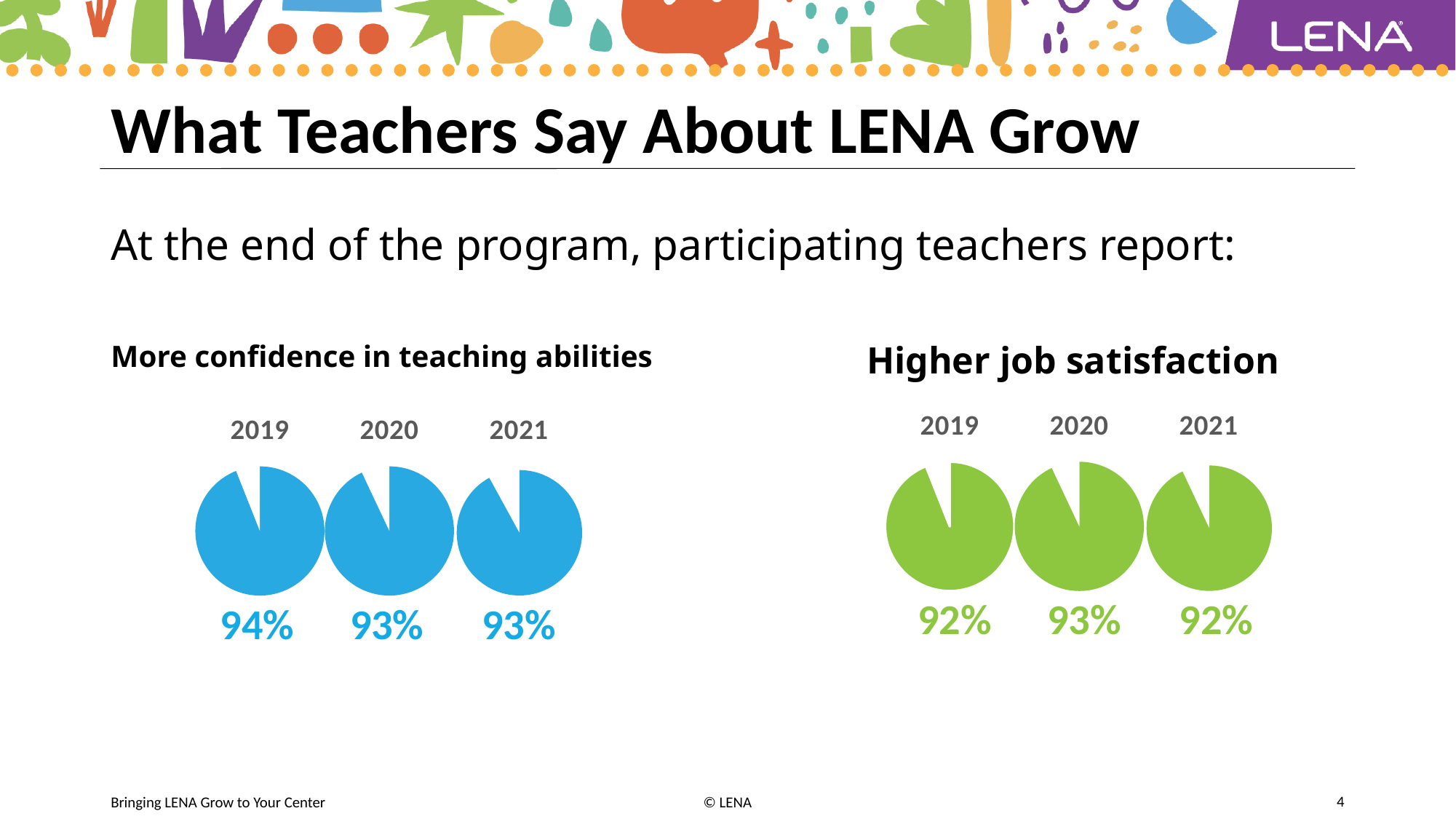
In the 'More confidence in teaching abilities' charts, which year has the highest percentage? 2019 In the 'Higher job satisfaction' charts, what is the difference between the 2020 and 2021 percentages? 1% In the 'More confidence in teaching abilities' charts, what is the difference between the 2019 and 2020 percentages? 1% In the 'Higher job satisfaction' charts, which year has the highest percentage? 2020 What kind of chart is used to show the 'More confidence in teaching abilities' values? Pie chart How many years are shown in the 'Higher job satisfaction' charts? 3 Which is larger: the 2019 value for 'More confidence in teaching abilities' or the 2019 value for 'Higher job satisfaction'? More confidence in teaching abilities What colour are the 'Higher job satisfaction' pie charts? Green In the 'More confidence in teaching abilities' charts, what percentage is shown for 2019? 94% In the 'Higher job satisfaction' charts, what percentage is shown for 2020? 93% In the 'More confidence in teaching abilities' charts, what percentage is shown for 2021? 93% In the 'Higher job satisfaction' charts, what percentage is shown for 2019? 92%